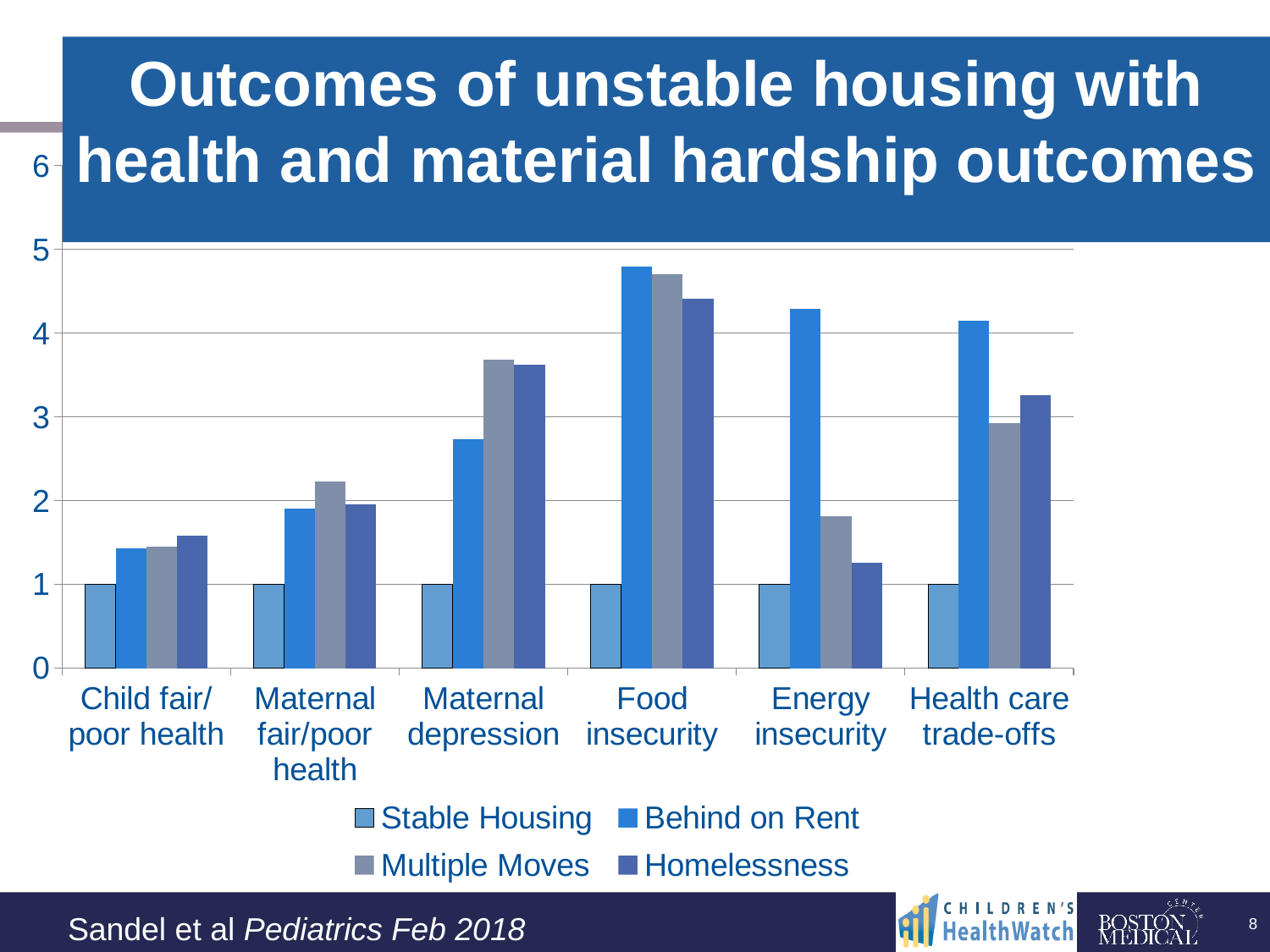
What is the value of the Stable Housing bar for Food insecurity? 1 Which category has the highest Behind on Rent bar? Food insecurity Is the Homelessness value for Energy insecurity greater or less than 2? less What is the title of the chart? Outcomes of unstable housing with health and material hardship outcomes For Energy insecurity, which is larger: Behind on Rent or Multiple Moves? Behind on Rent Is the Behind on Rent value for Food insecurity greater or less than 4? greater Is the Multiple Moves value for Maternal fair/poor health greater or less than 2? greater For Maternal depression, which is larger: Multiple Moves or Behind on Rent? Multiple Moves How many outcome categories are shown along the x axis? 6 How many series does the legend list? 4 Which category has the lowest Homelessness bar? Energy insecurity What kind of chart is shown on the slide? bar chart